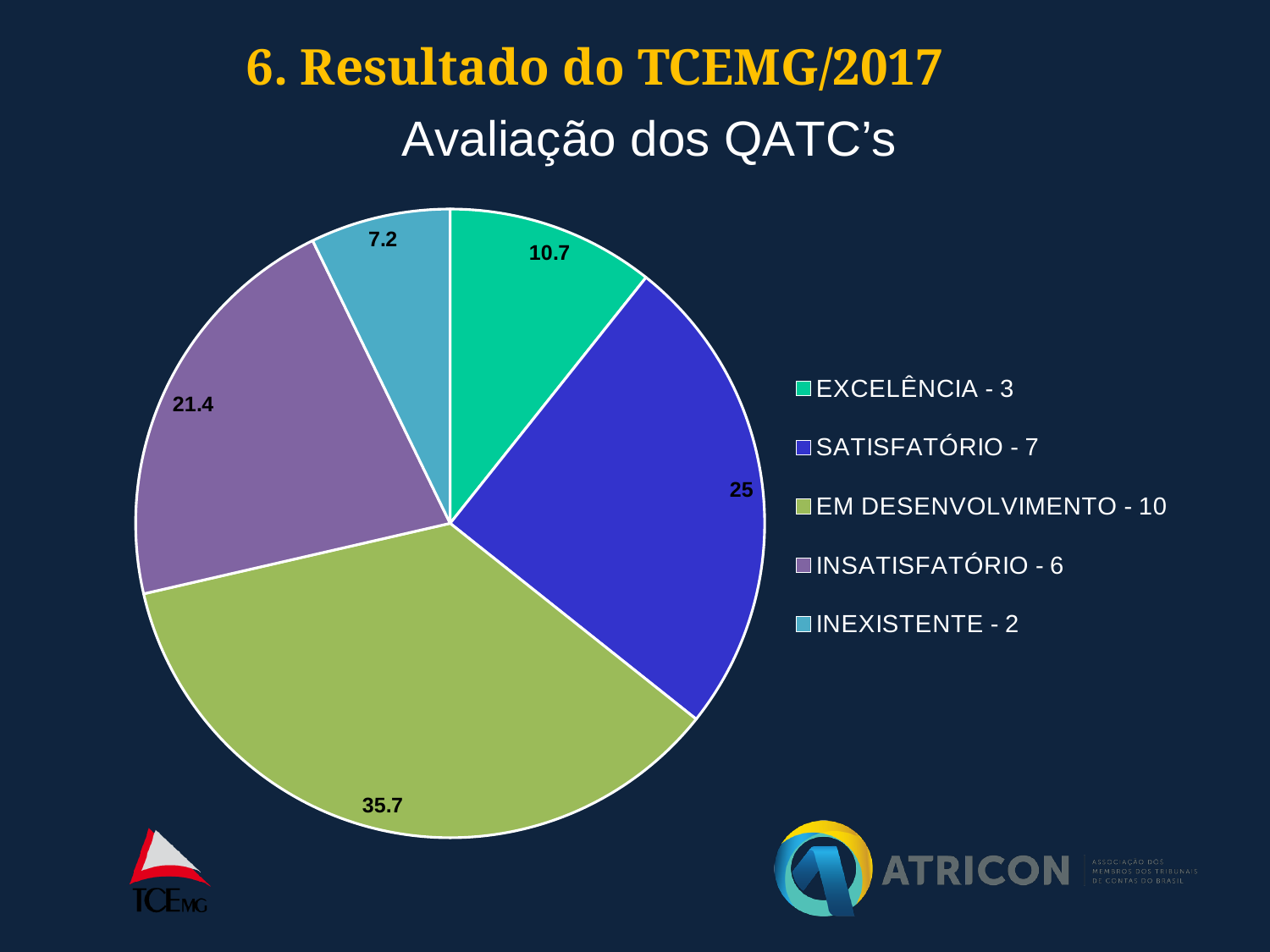
What is the subtitle of the chart on the slide? Avaliação dos QATC's According to the legend, how many QATC's were rated EM DESENVOLVIMENTO? 10 What value is printed on the EXCELÊNCIA slice? 10.7 How many slices does the pie chart have? 5 What value is printed on the EM DESENVOLVIMENTO slice? 35.7 Which category has the smallest slice of the pie? INEXISTENTE What value is printed on the INEXISTENTE slice? 7.2 Which slice is larger, SATISFATÓRIO or INSATISFATÓRIO? SATISFATÓRIO What value is printed on the SATISFATÓRIO slice? 25 What is the difference between the values printed on the EM DESENVOLVIMENTO and INSATISFATÓRIO slices? 14.3 Which category has the largest slice of the pie? EM DESENVOLVIMENTO What kind of chart is shown on the slide? pie chart